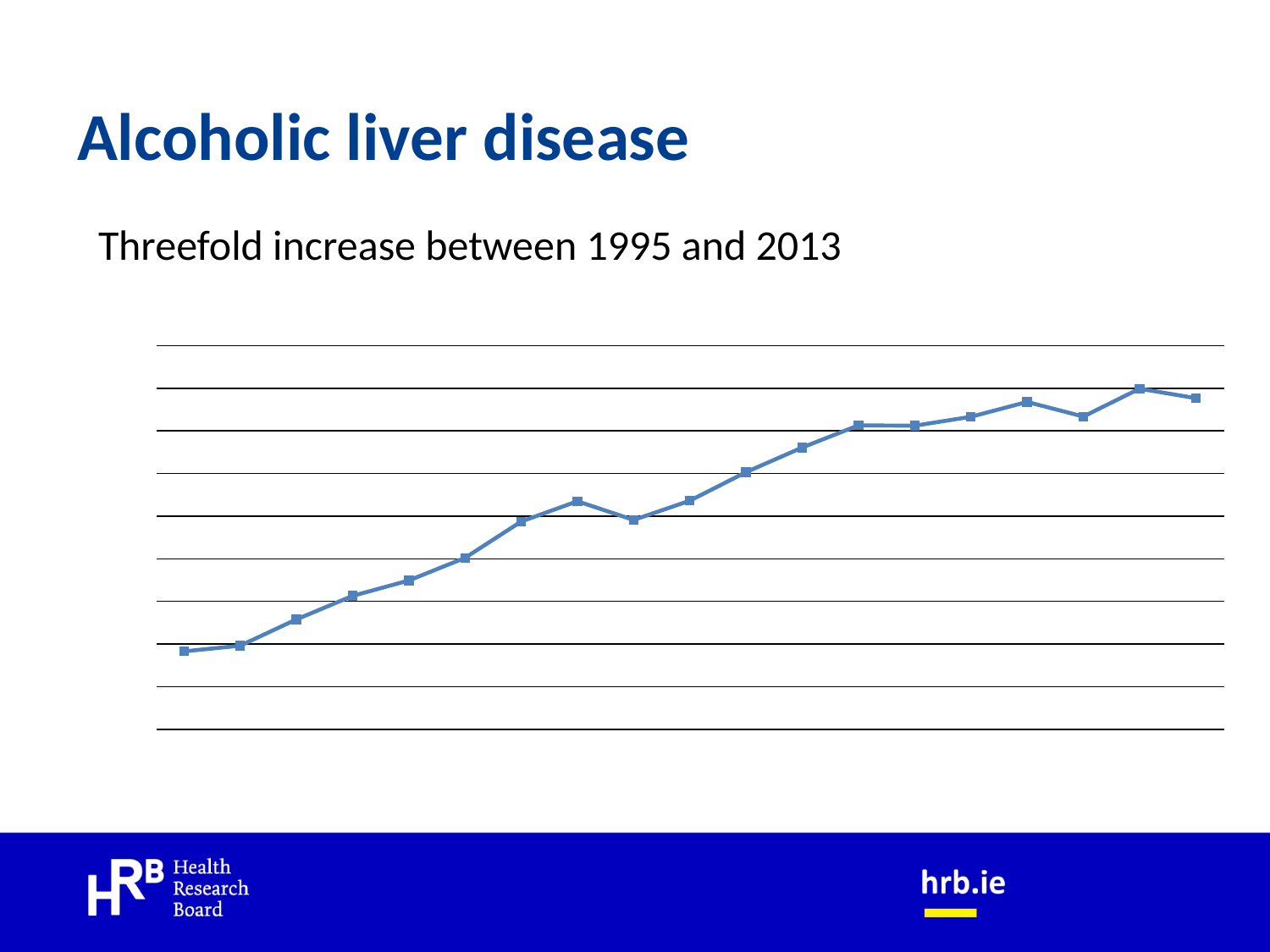
Is the last point on the line higher or lower than the first point? higher Do the values generally rise or fall from left to right along the x axis? rise According to the slide text, between which years was there a threefold increase? 1995 and 2013 What is the title of the slide containing the chart? Alcoholic liver disease How many lines (series) are plotted on the chart? 1 What kind of chart is shown on the slide? line chart How many data points are plotted on the line? 19